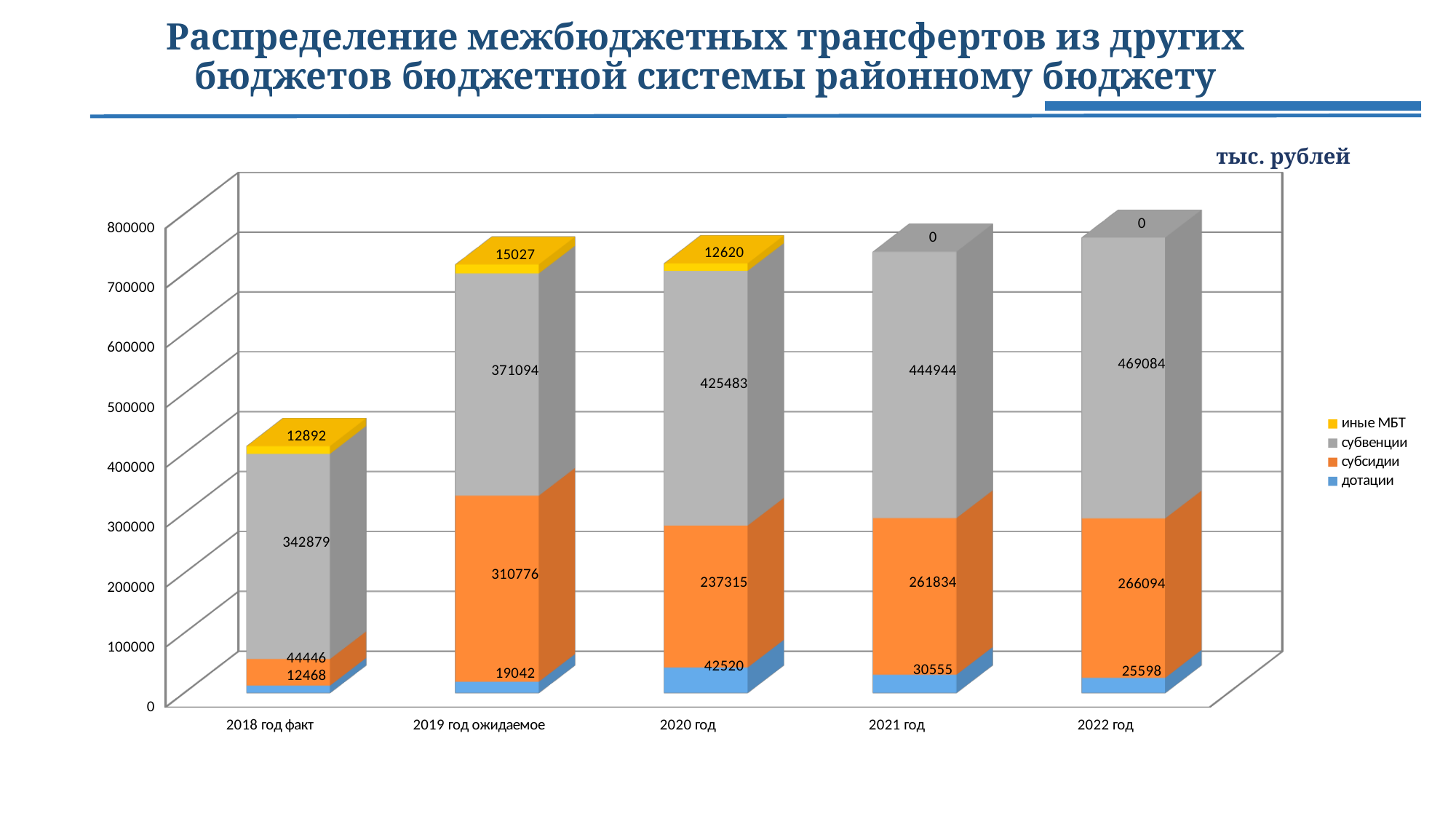
Which year has the lowest value for субсидии? 2018 год факт What is the value of дотации for 2018 год факт? 12468 How many series does the legend list? 4 What is the value of иные МБТ for 2019 год ожидаемое? 15027 What is the total of the stacked bar for 2021 год? 737333 Which year has the highest value for субвенции? 2022 год What is the difference between субсидии in 2022 год and 2021 год? 4260 Which is larger: дотации in 2020 год or дотации in 2021 год? 2020 год What kind of chart is shown on the slide? Stacked bar chart What is the value of субвенции for 2020 год? 425483 What unit of measurement is indicated above the chart? тыс. рублей How many year categories are shown on the x axis? 5